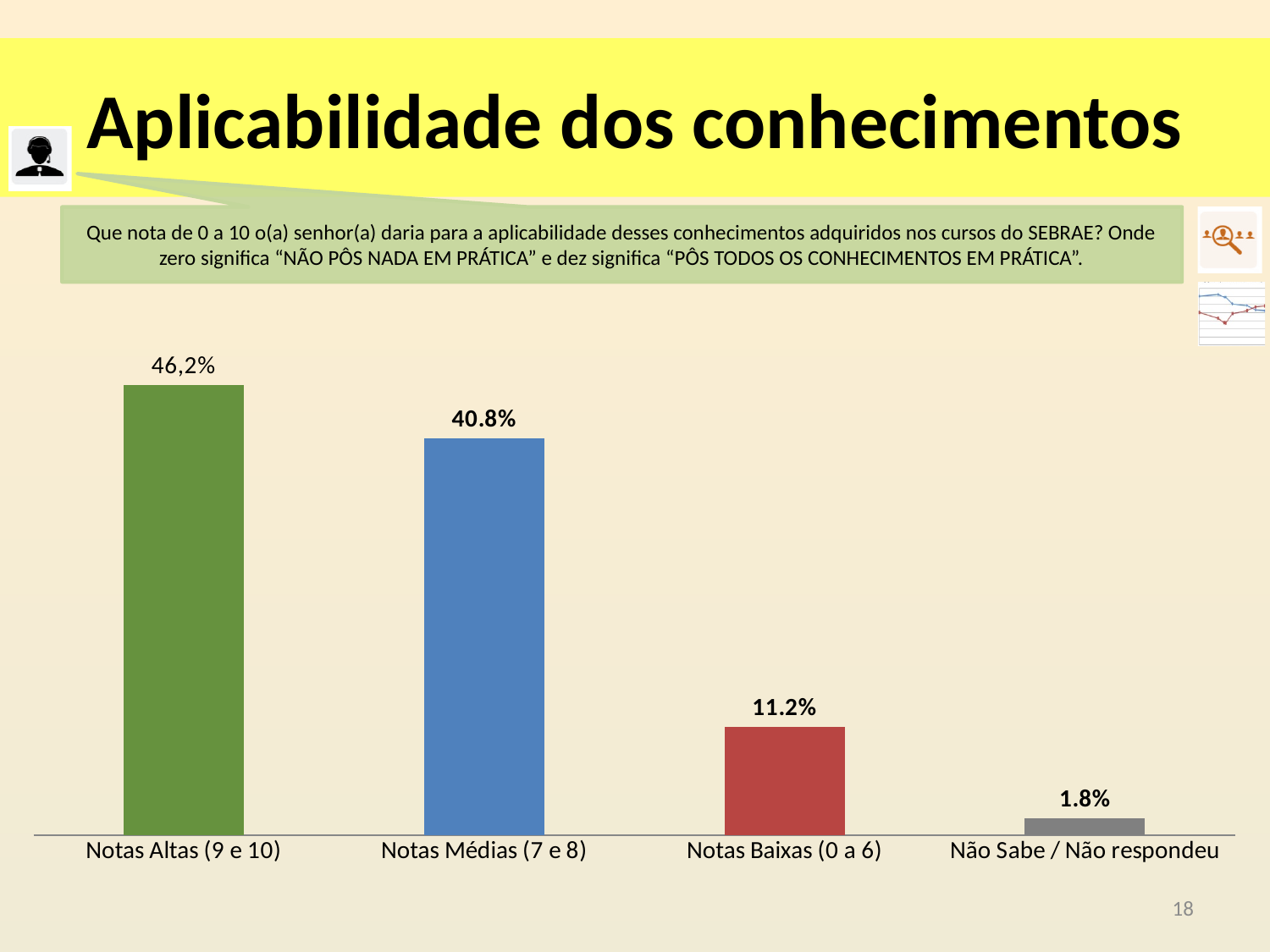
What is the value for Notas Baixas (0 a 6)? 11.2% What is the value for Notas Altas (9 e 10)? 46,2% What is the difference between the values for Notas Baixas (0 a 6) and Não Sabe / Não respondeu? 9.4% What is the difference between the values for Notas Médias (7 e 8) and Notas Baixas (0 a 6)? 29.6% What kind of chart is shown on the slide? Bar chart What is the value for Notas Médias (7 e 8)? 40.8% Do the values rise or fall from left to right across the categories? Fall How many categories are shown in the chart? 4 Which is larger, the value for Notas Altas (9 e 10) or the value for Notas Médias (7 e 8)? Notas Altas (9 e 10) What is the value for Não Sabe / Não respondeu? 1.8% Which category has the highest value? Notas Altas (9 e 10) Which category has the lowest value? Não Sabe / Não respondeu